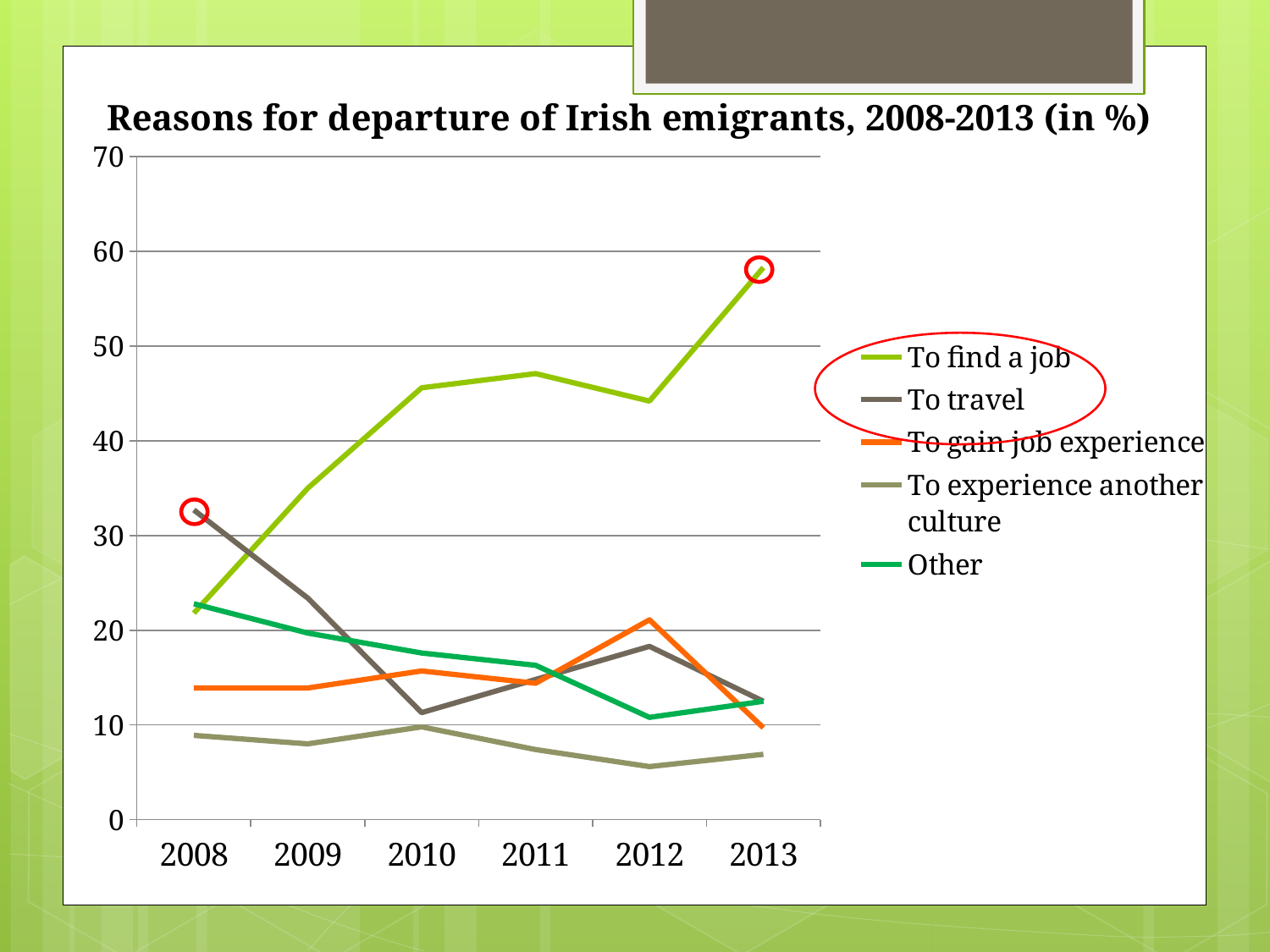
Which reason has the lowest value in 2013? To experience another culture How many series does the legend list? 5 What kind of chart is shown on the slide? Line chart Is the value for 'To experience another culture' in 2012 greater or less than 10? less In 2008, which is larger: 'To travel' or 'To find a job'? To travel Is the value for 'To find a job' in 2013 greater or less than 50? greater Is the value for 'To travel' in 2008 greater or less than 30? greater Does the 'To find a job' line rise or fall overall from 2008 to 2013? rise Which reason has the highest value in 2008? To travel What is the title of the chart? Reasons for departure of Irish emigrants, 2008-2013 (in %) Which reason has the highest value in 2013? To find a job How many years are shown on the x axis? 6